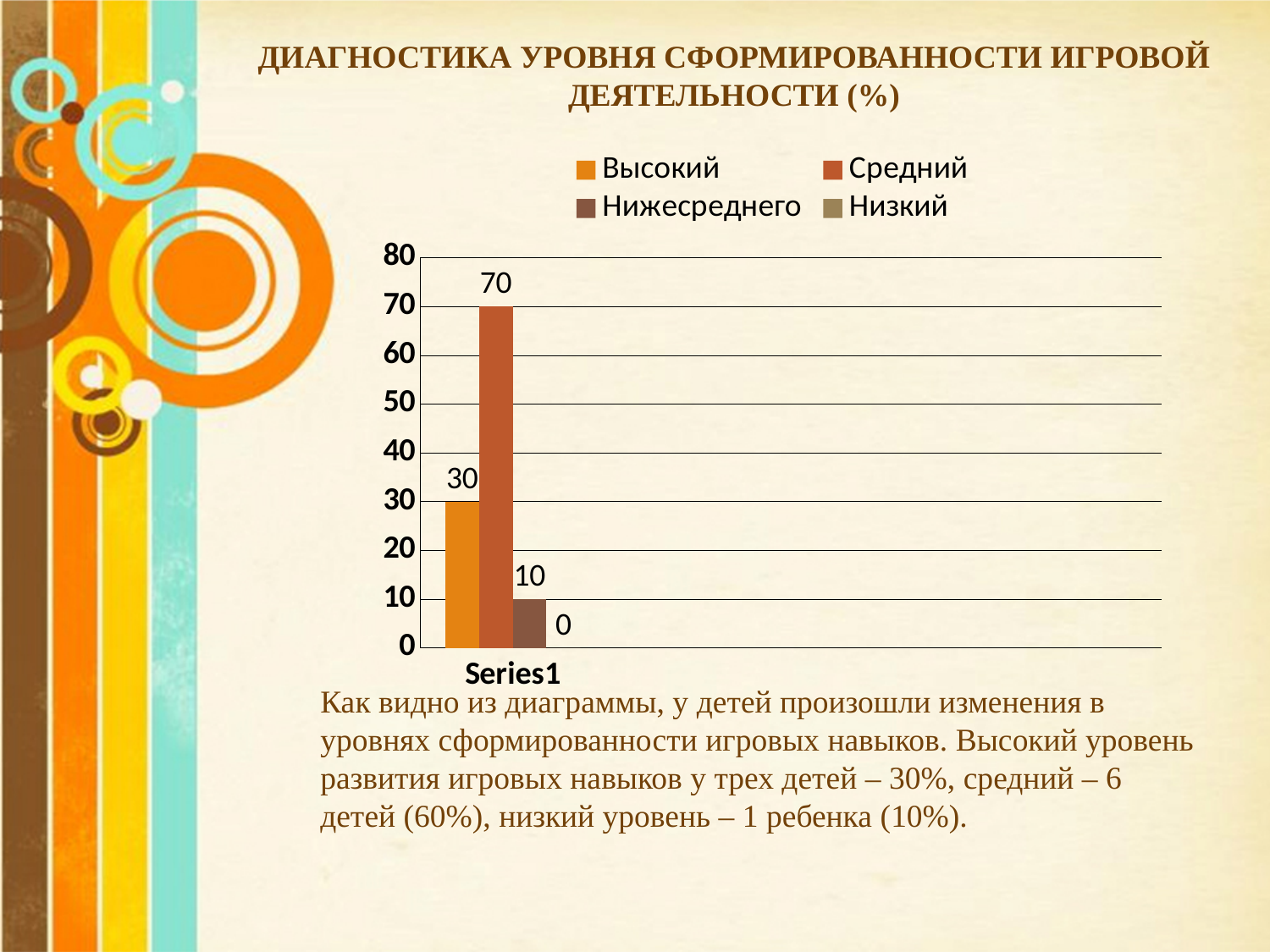
What is the value for Средний? 70 What is the value for Высокий? 30 What is the difference between the values for Средний and Высокий? 40 What is the highest value shown on the y axis? 80 What is the label of the category on the x axis? Series1 Which series has the highest value? Средний What kind of chart is shown on the slide? Bar chart What is the value for Низкий? 0 How many series does the legend list? 4 Which series has the lowest value? Низкий What is the value for Нижесреднего? 10 Which is larger, the value for Высокий or the value for Нижесреднего? Высокий